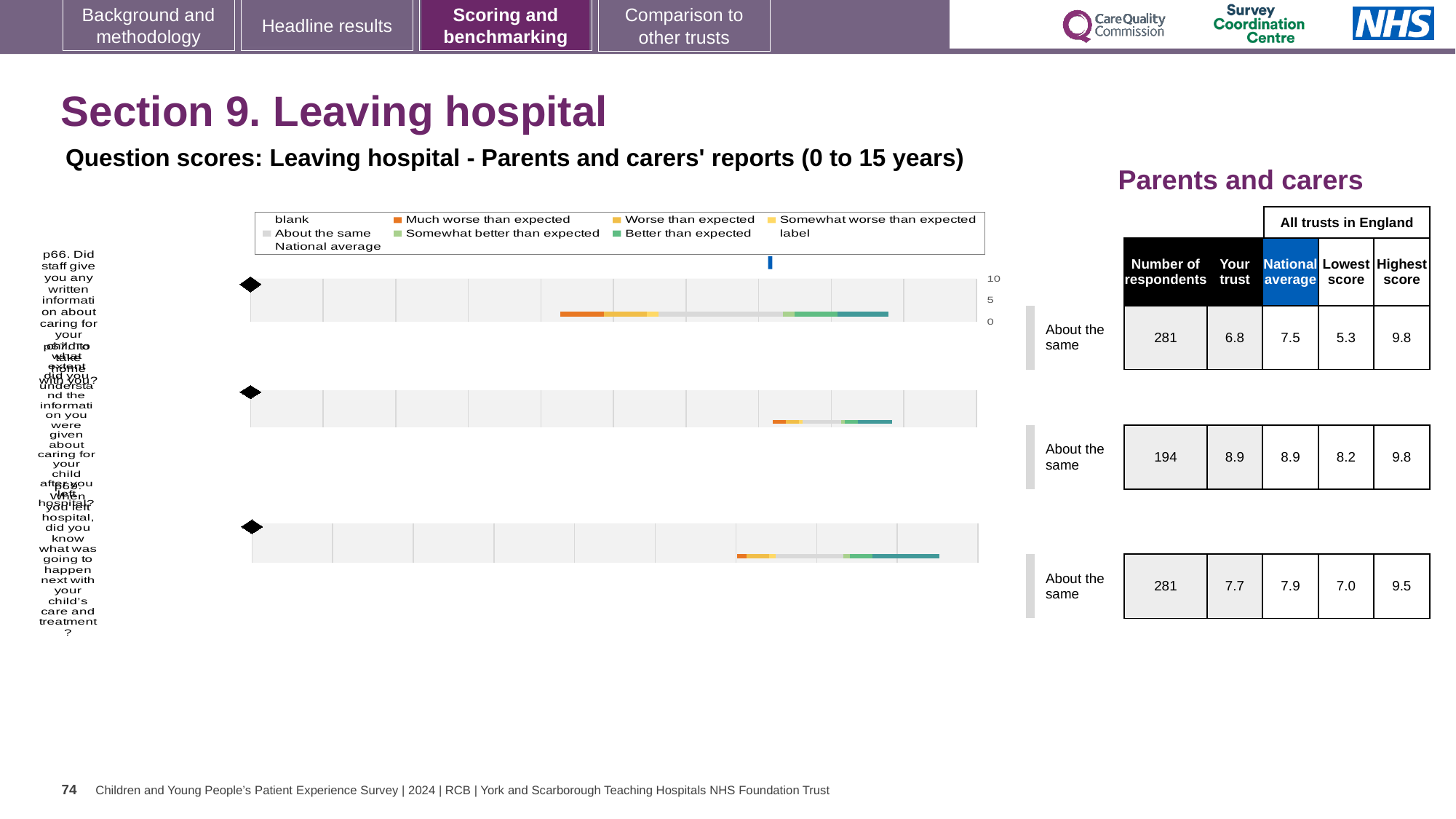
For the bottom question row, what is the highest score among all trusts in England? 9.5 How many question rows (charts) are shown on the slide? 3 Which colour in the legend represents 'Much worse than expected'? Orange For the top question row, what is the national average score? 7.5 For the middle question row, what is the lowest score among all trusts in England? 8.2 For the bottom question row, which is larger: the 'Your trust' score or the national average? National average For the top question row, what is the 'Your trust' score? 6.8 What benchmark category is shown for all three question rows? About the same Which question row has the highest 'Your trust' score? The middle row (8.9) For the middle question row, how many respondents are there? 194 For the top question row, what is the difference between the highest score and the lowest score? 4.5 What kind of chart is used to show the question scores on this slide? bar chart